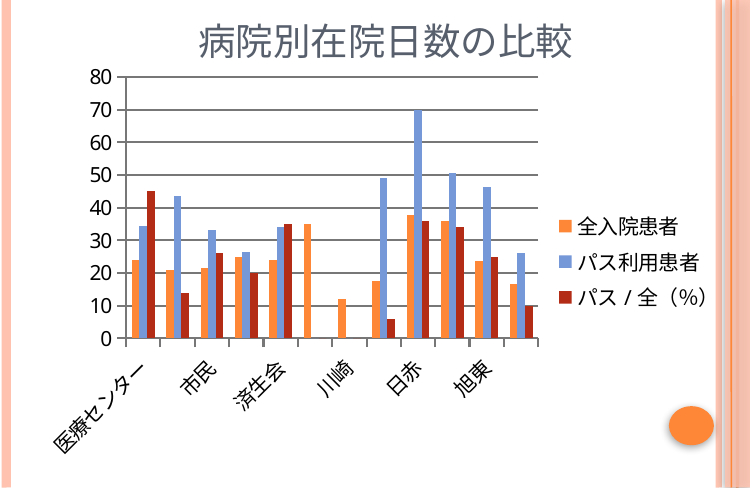
What is the title of the chart? 病院別在院日数の比較 Is the value of 全入院患者 for 医療センター greater or less than 30? less What is the maximum value shown on the vertical axis? 80 Is the value of パス / 全（%） for 医療センター greater or less than 40? greater What kind of chart is shown on the slide? bar chart Is the highest value for パス利用患者 greater or less than 60? greater Which series is shown in blue in the legend? パス利用患者 For 医療センター, which is larger: パス利用患者 or 全入院患者? パス利用患者 How many series does the legend list? 3 Which series contains the tallest bar in the chart? パス利用患者 For 医療センター, which is larger: 全入院患者 or パス / 全（%）? パス / 全（%）